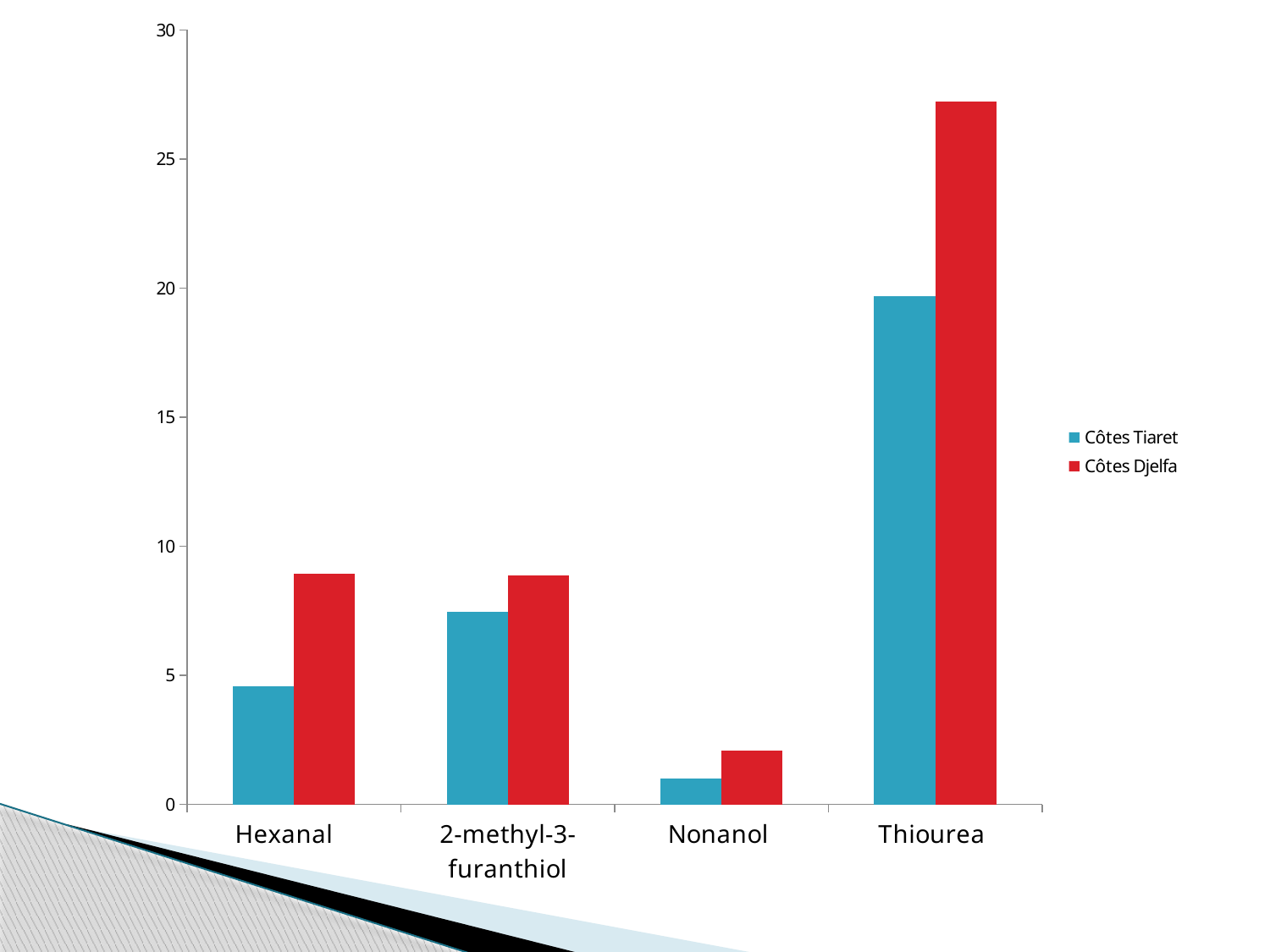
For Hexanal, which series has the larger value, Côtes Tiaret or Côtes Djelfa? Côtes Djelfa Which category has the highest value for Côtes Djelfa? Thiourea Is the Côtes Djelfa value for Thiourea greater or less than 25? greater What kind of chart is shown on the slide? bar chart How many categories are shown on the x axis? 4 How many series does the legend list? 2 Is the Côtes Tiaret value for 2-methyl-3-furanthiol greater or less than 5? greater Which category has the lowest value for Côtes Tiaret? Nonanol Which category has the lowest value for Côtes Djelfa? Nonanol Is the Côtes Tiaret value for Hexanal greater or less than 5? less Which colour represents Côtes Djelfa in the legend? red